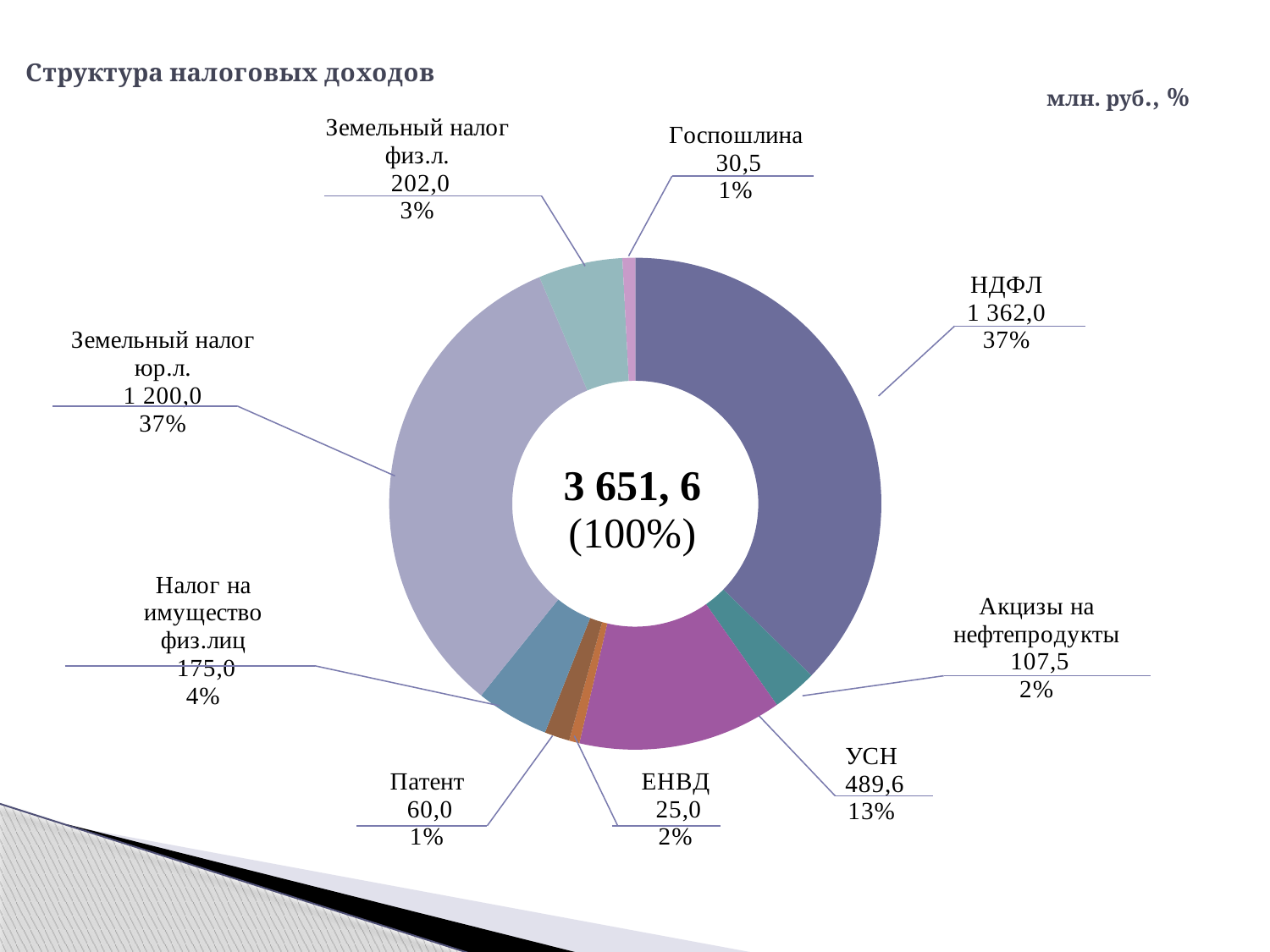
What is the difference between the values for НДФЛ and Земельный налог юр.л.? 162,0 What is the value for НДФЛ? 1 362,0 What total is shown in the centre of the chart? 3 651, 6 (100%) Which is larger, the value for Патент or the value for Госпошлина? Патент What is the value for Акцизы на нефтепродукты? 107,5 What share of tax revenues does УСН account for? 13% How many categories are shown in the chart? 9 What type of chart is shown on the slide? Doughnut (pie) chart Which category has the smallest value? ЕНВД Which category has the largest value? НДФЛ What is the value for Земельный налог юр.л.? 1 200,0 What is the title of the chart? Структура налоговых доходов